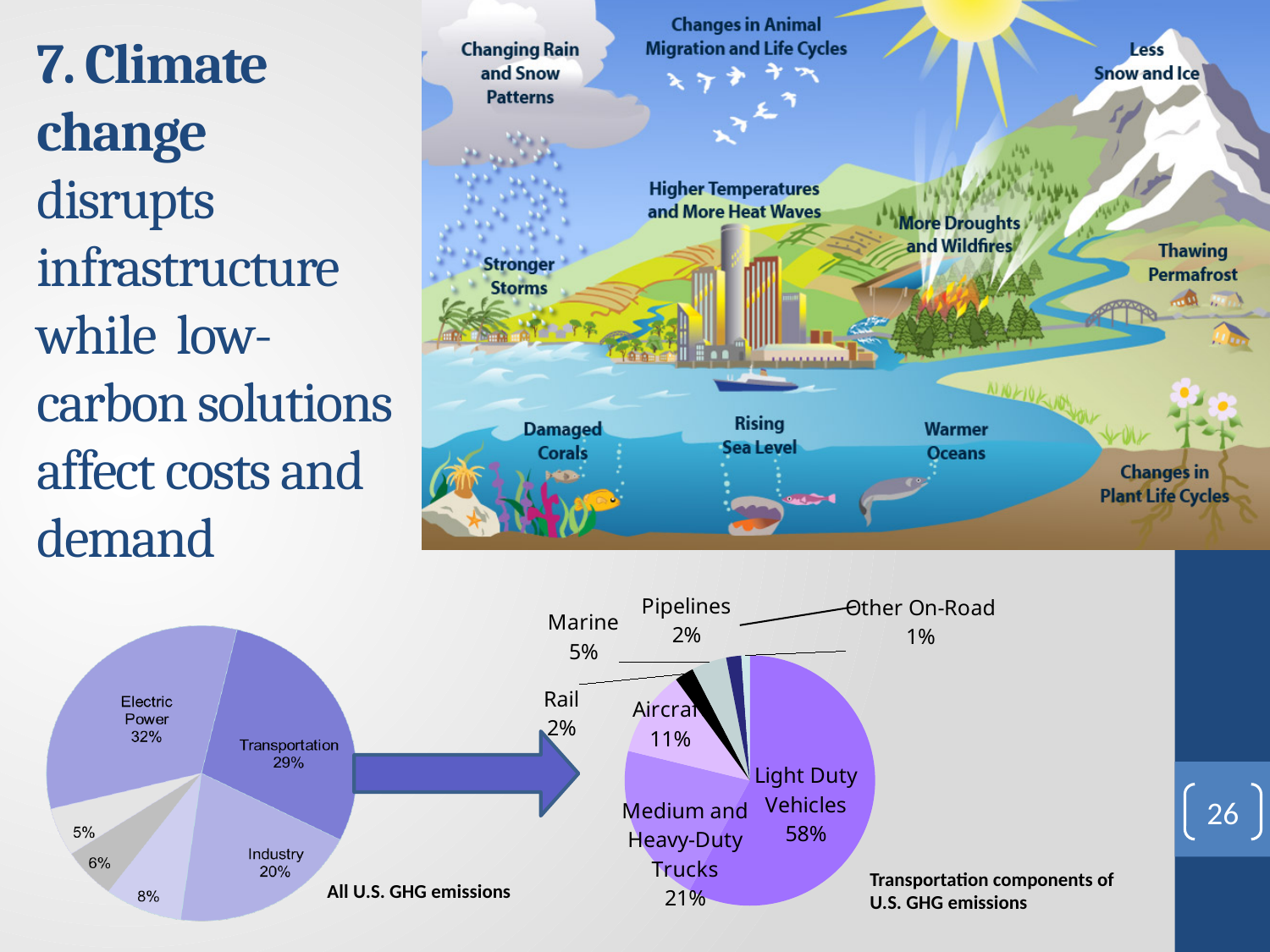
In the 'All U.S. GHG emissions' chart, what is the difference between the Electric Power and Industry shares? 12% In the 'All U.S. GHG emissions' chart, what share is Industry? 20% How many components are shown in the 'Transportation components of U.S. GHG emissions' chart? 7 In the 'All U.S. GHG emissions' chart, which labelled sector has the largest share? Electric Power What kind of chart is the 'Transportation components of U.S. GHG emissions' chart? Pie chart In the 'Transportation components of U.S. GHG emissions' chart, what share is Light Duty Vehicles? 58% In the 'Transportation components of U.S. GHG emissions' chart, which component has the smallest share? Other On-Road In the 'Transportation components of U.S. GHG emissions' chart, what share is Medium and Heavy-Duty Trucks? 21% In the 'Transportation components of U.S. GHG emissions' chart, which is larger, Marine or Rail? Marine In the 'All U.S. GHG emissions' chart, what share is Electric Power? 32% In the 'All U.S. GHG emissions' chart, what share is Transportation? 29% In the 'Transportation components of U.S. GHG emissions' chart, what share is Aircraft? 11%